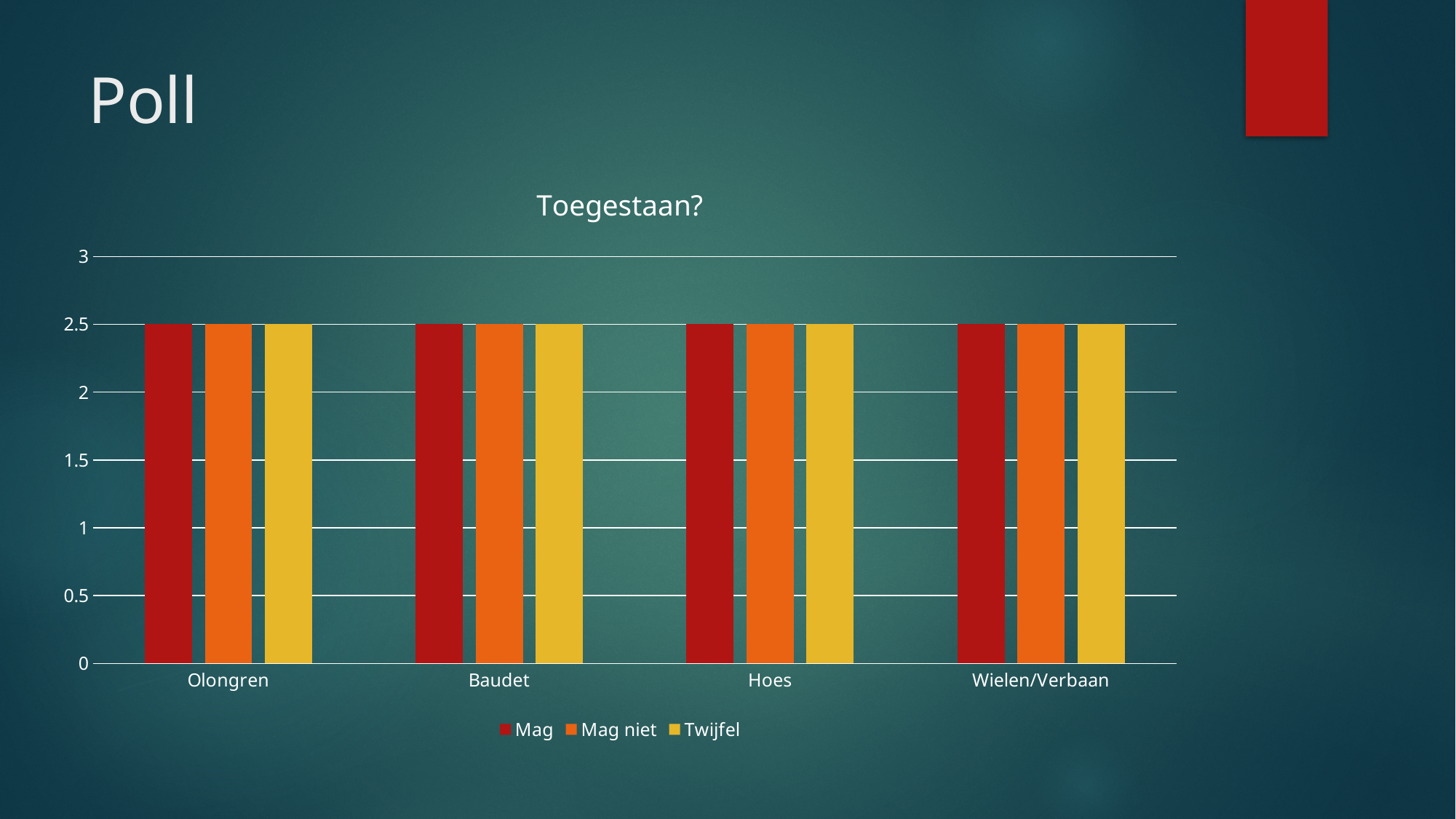
How many categories are shown on the x axis? 4 What is the value of the Mag series for Wielen/Verbaan? 2.5 What is the value of the Twijfel series for Baudet? 2.5 What is the value of the Mag series for Olongren? 2.5 Is the value of Twijfel for Hoes greater or less than 3? less Which series is shown in yellow in the legend? Twijfel What is the difference between the Mag value for Olongren and the Mag value for Hoes? 0 Is the value of Mag niet for Baudet greater or less than 2? greater What kind of chart is shown on the slide? bar chart How many series does the legend list? 3 What is the title of the chart? Toegestaan? What is the value of the Mag niet series for Hoes? 2.5